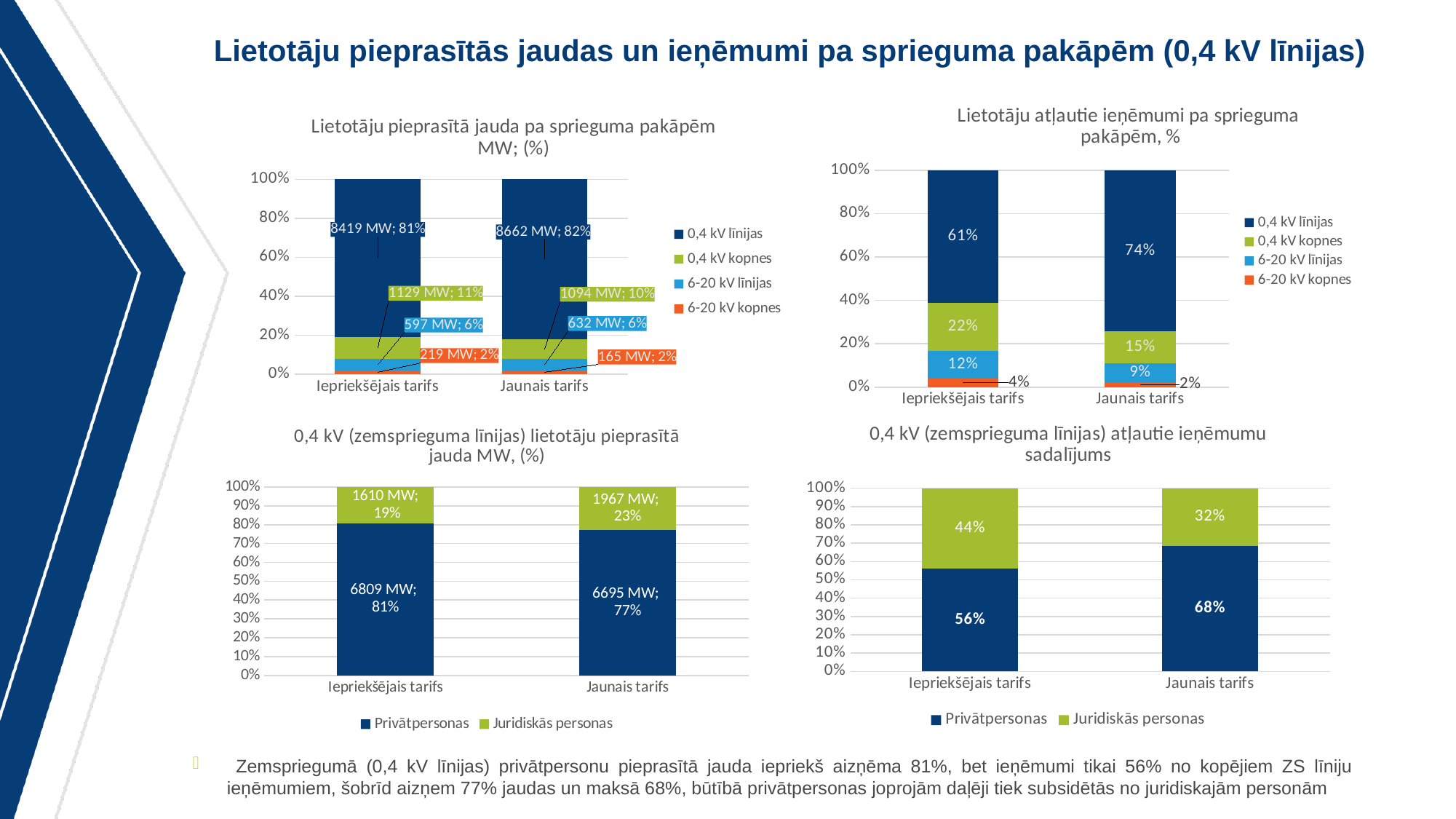
In the top-left chart 'Lietotāju pieprasītā jauda pa sprieguma pakāpēm MW; (%)', how many series does the legend list? 4 In the top-right chart 'Lietotāju atļautie ieņēmumi pa sprieguma pakāpēm, %', what is the value for 0,4 kV kopnes under Iepriekšējais tarifs? 22% In the bottom-left chart '0,4 kV (zemsprieguma līnijas) lietotāju pieprasītā jauda MW, (%)', what is the data label for Juridiskās personas under Jaunais tarifs? 1967 MW; 23% In the bottom-right chart '0,4 kV (zemsprieguma līnijas) atļautie ieņēmumu sadalījums', which is larger under Iepriekšējais tarifs: Privātpersonas or Juridiskās personas? Privātpersonas In the top-right chart 'Lietotāju atļautie ieņēmumi pa sprieguma pakāpēm, %', what is the value for 0,4 kV līnijas under Jaunais tarifs? 74% In the bottom-left chart '0,4 kV (zemsprieguma līnijas) lietotāju pieprasītā jauda MW, (%)', what is the difference in MW between Privātpersonas under Iepriekšējais tarifs and Privātpersonas under Jaunais tarifs? 114 MW In the bottom-right chart '0,4 kV (zemsprieguma līnijas) atļautie ieņēmumu sadalījums', what is the value for Privātpersonas under Jaunais tarifs? 68% In the bottom-right chart '0,4 kV (zemsprieguma līnijas) atļautie ieņēmumu sadalījums', how many categories are shown on the x axis? 2 In the top-right chart 'Lietotāju atļautie ieņēmumi pa sprieguma pakāpēm, %', which series has the smallest share under Jaunais tarifs? 6-20 kV kopnes In the top-left chart 'Lietotāju pieprasītā jauda pa sprieguma pakāpēm MW; (%)', what is the data label for 0,4 kV līnijas under Iepriekšējais tarifs? 8419 MW; 81% In the top-left chart 'Lietotāju pieprasītā jauda pa sprieguma pakāpēm MW; (%)', what is the data label for 6-20 kV kopnes under Jaunais tarifs? 165 MW; 2% What kind of chart is the bottom-left chart '0,4 kV (zemsprieguma līnijas) lietotāju pieprasītā jauda MW, (%)'? Stacked bar chart